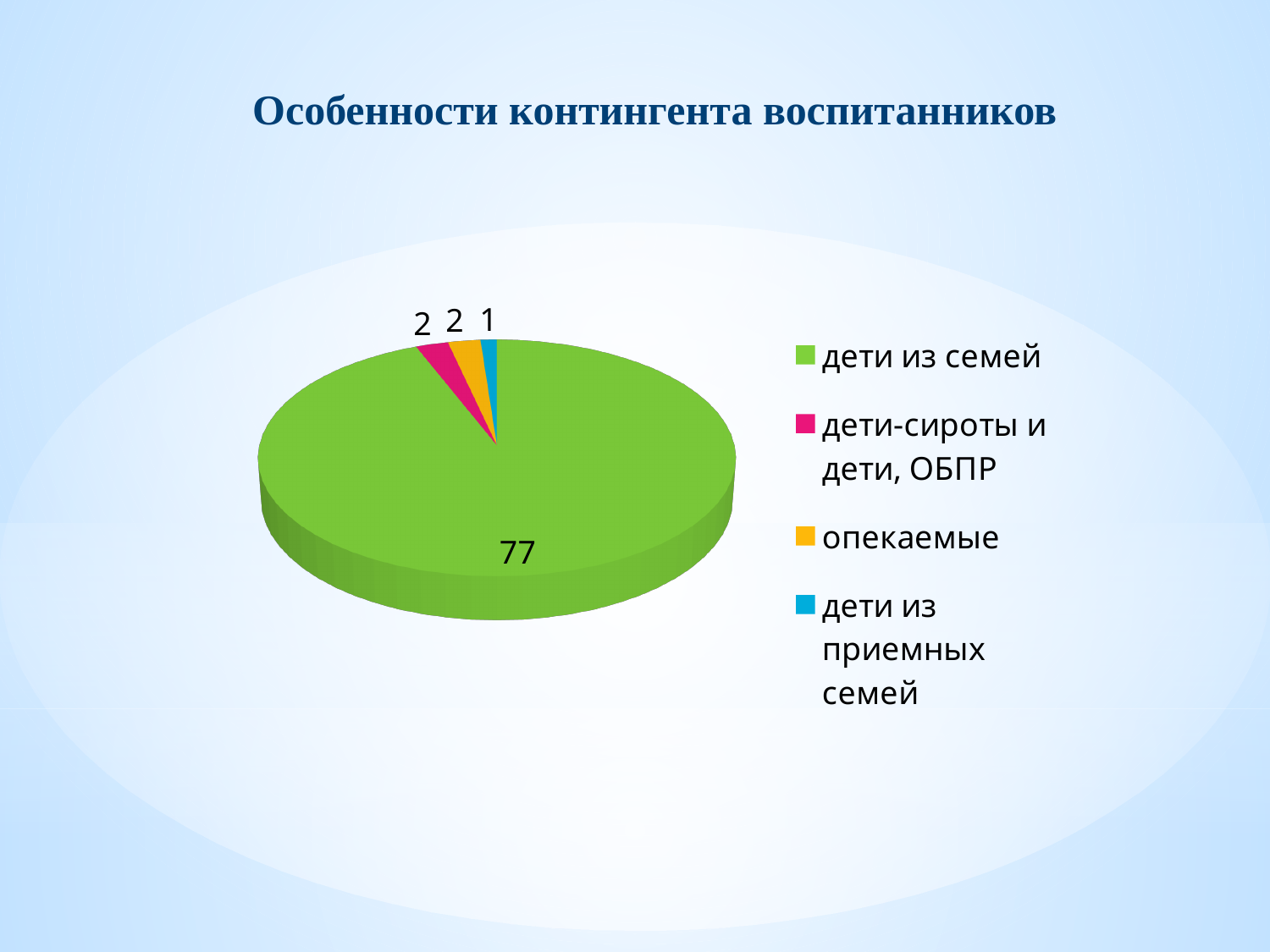
What is the title of the slide? Особенности контингента воспитанников What is the value for дети из семей? 77 What kind of chart is shown on the slide? pie chart What is the value for дети-сироты и дети, ОБПР? 2 What is the difference between the values for дети из семей and опекаемые? 75 Which is larger, the value for опекаемые or the value for дети из приемных семей? опекаемые What is the value for опекаемые? 2 What is the sum of all the slice values? 82 What is the value for дети из приемных семей? 1 How many categories does the legend list? 4 Which category has the largest slice? дети из семей Which category has the smallest slice? дети из приемных семей